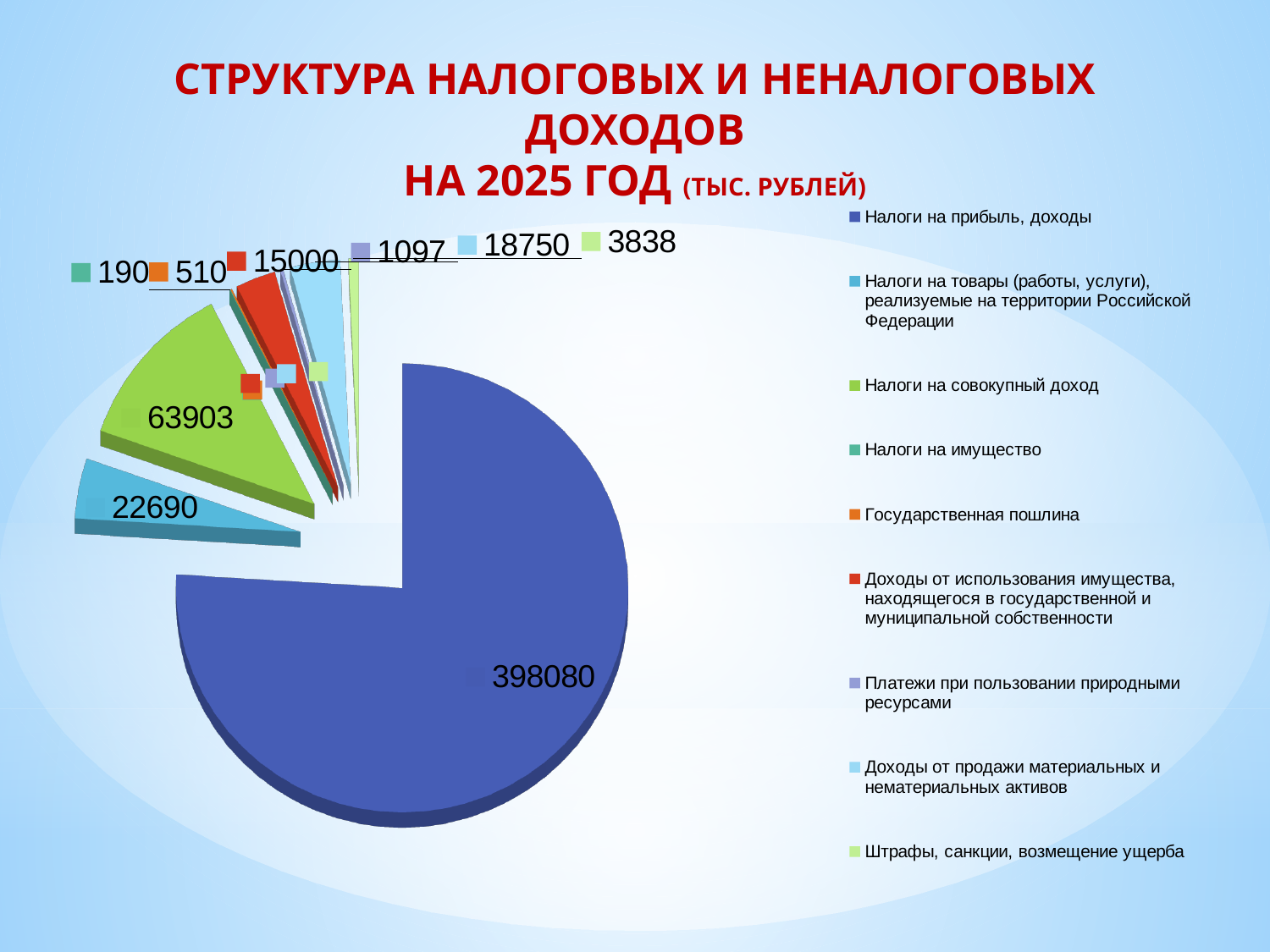
How many categories does the legend list? 9 What is the value for "Налоги на товары (работы, услуги), реализуемые на территории Российской Федерации"? 22690 Which is larger: "Доходы от продажи материальных и нематериальных активов" or "Доходы от использования имущества, находящегося в государственной и муниципальной собственности"? Доходы от продажи материальных и нематериальных активов What is the value for "Налоги на совокупный доход"? 63903 Which category has the largest slice of the pie? Налоги на прибыль, доходы What is the value for "Налоги на прибыль, доходы"? 398080 What type of chart is shown on the slide? Pie chart Which category has the smallest value? Налоги на имущество What is the value for "Штрафы, санкции, возмещение ущерба"? 3838 In what units are the values on the chart given, according to the title? тыс. рублей What is the difference between the values for "Налоги на совокупный доход" and "Налоги на товары (работы, услуги), реализуемые на территории Российской Федерации"? 41213 What is the value for "Доходы от продажи материальных и нематериальных активов"? 18750